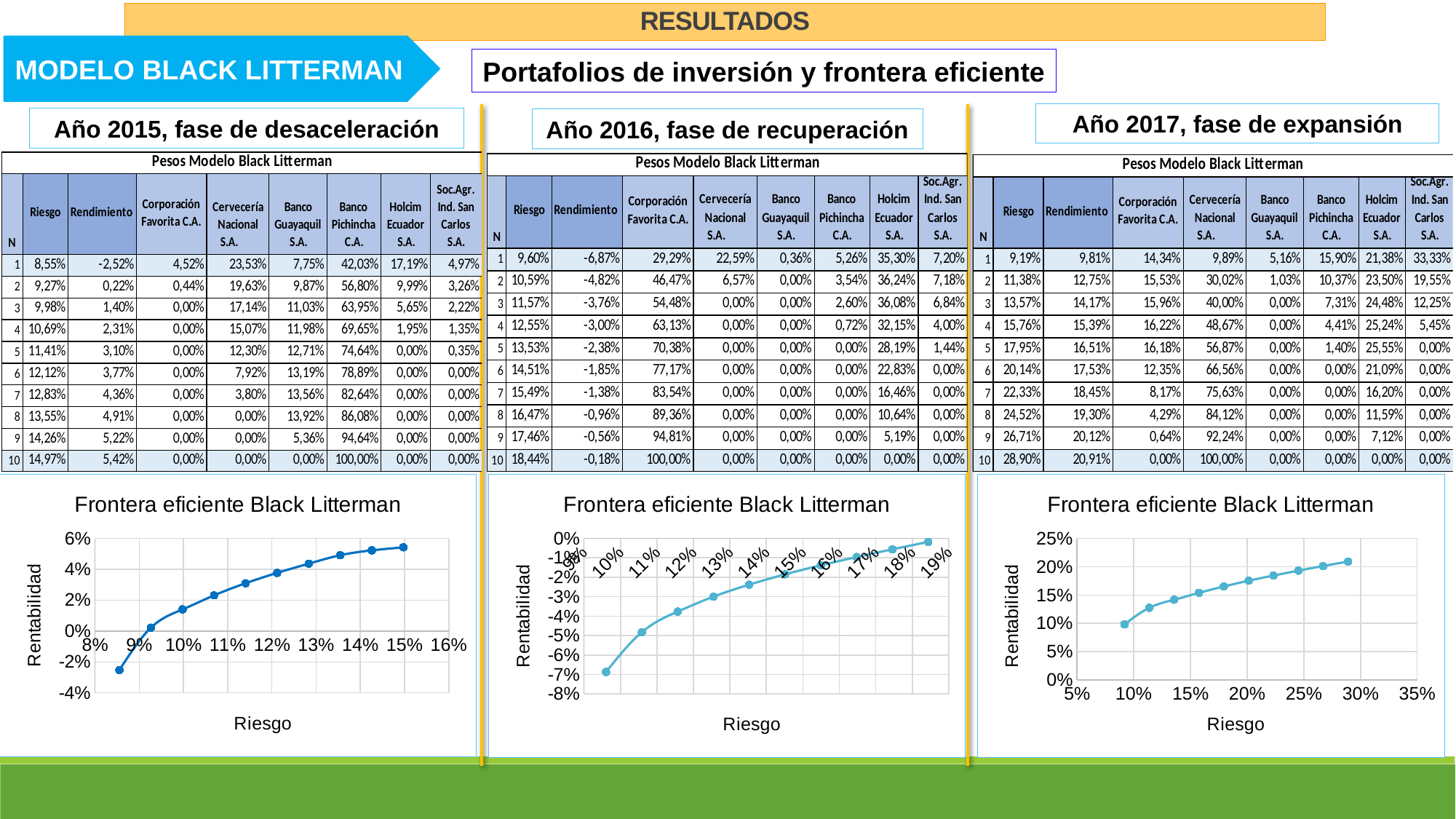
What is the x-axis title of the 'Frontera eficiente Black Litterman' charts? Riesgo Which of the three 'Frontera eficiente Black Litterman' charts reaches the highest Rentabilidad value? The right chart (Año 2017) In the right chart (Año 2017), is the Rentabilidad of the point at about 20% Riesgo greater or less than 15%? greater In the right chart (Año 2017), does Rentabilidad increase or decrease as Riesgo increases? Increases In the left chart (Año 2015), is the Rentabilidad of the point at 15% Riesgo greater or less than 4%? greater In the middle chart (Año 2016), is the Rentabilidad of the lowest-risk point greater or less than -6%? less In the left chart (Año 2015), does Rentabilidad rise or fall as Riesgo increases along the x axis? Rises What kind of chart is the 'Frontera eficiente Black Litterman' chart on the left (Año 2015)? Line chart In the middle chart (Año 2016), how many data points are plotted? 10 In the left chart (Año 2015), how many data points are plotted on the efficient frontier? 10